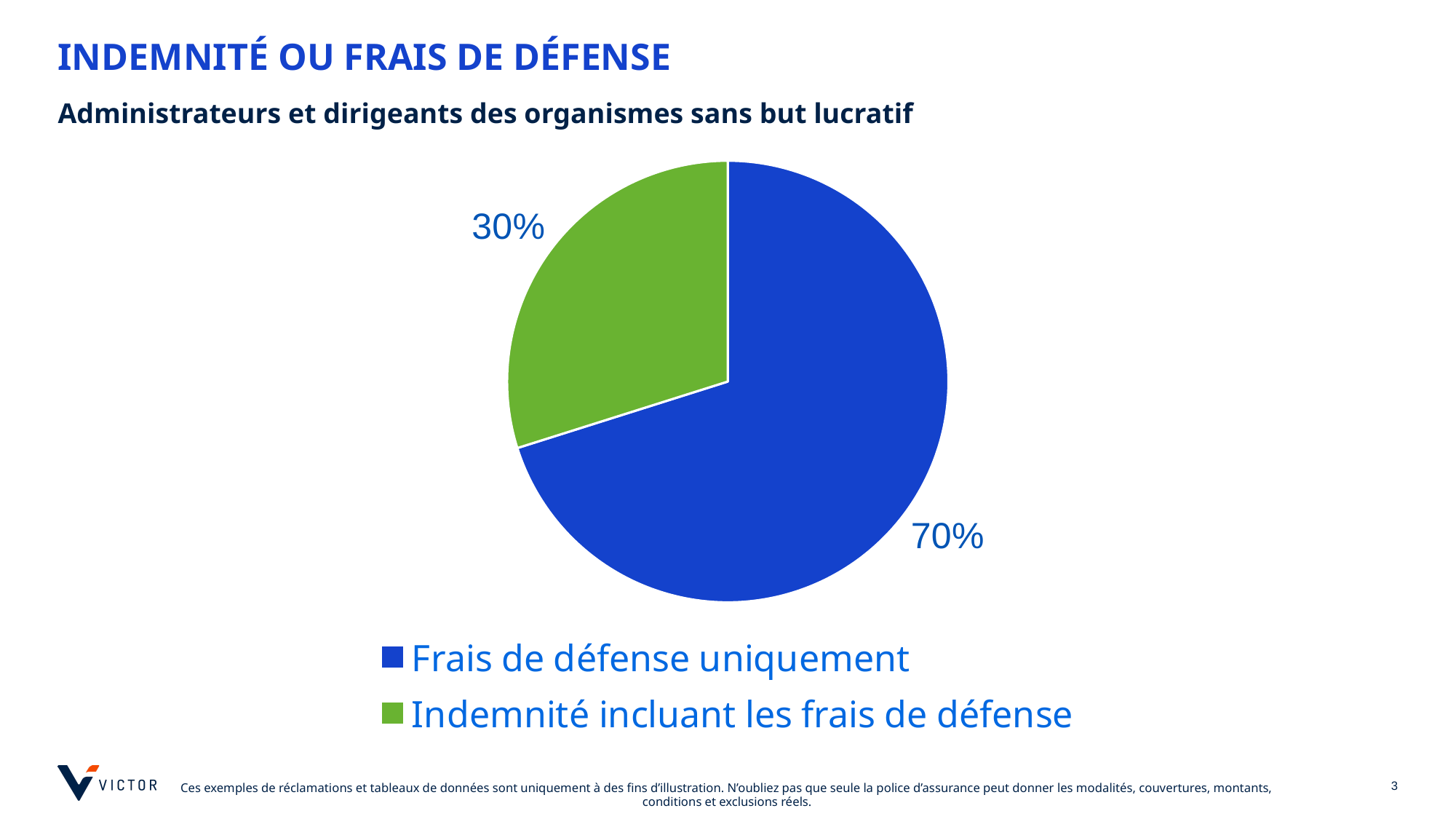
What is the difference in percentage points between 'Frais de défense uniquement' and 'Indemnité incluant les frais de défense'? 40 percentage points How many slices does the pie chart have? 2 What is the title of the slide containing the chart? INDEMNITÉ OU FRAIS DE DÉFENSE Which slice is the largest? Frais de défense uniquement What kind of chart is shown on the slide? Pie chart What share of the pie is 'Frais de défense uniquement'? 70% Which slice is the smallest? Indemnité incluant les frais de défense What colour is the 'Indemnité incluant les frais de défense' slice? Green What share of the pie is 'Indemnité incluant les frais de défense'? 30% How many entries does the legend list? 2 Which is larger: 'Frais de défense uniquement' or 'Indemnité incluant les frais de défense'? Frais de défense uniquement